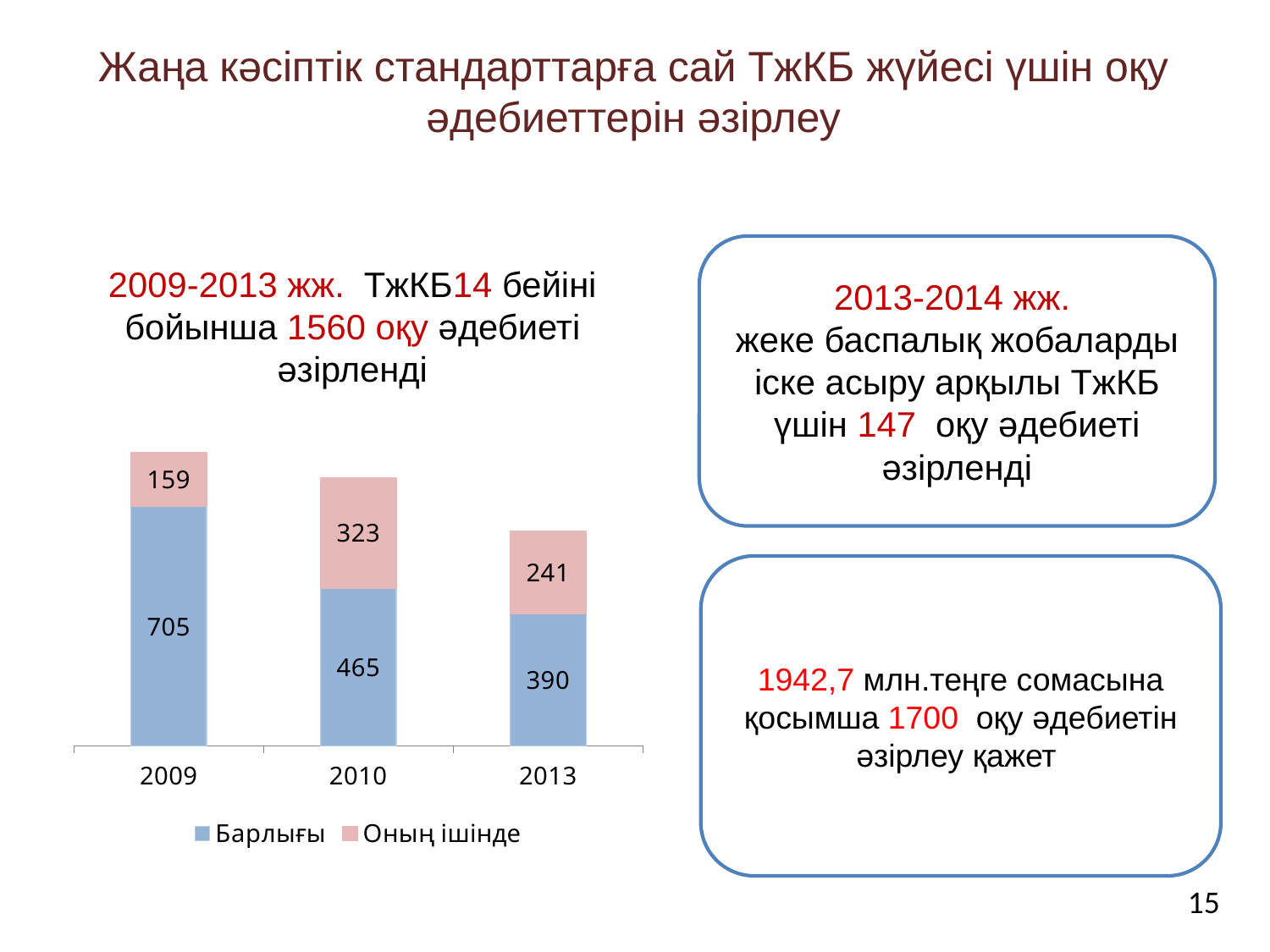
What kind of chart is shown on the slide? Stacked bar chart What is the difference between the Барлығы values for 2009 and 2013? 315 Which year has the highest value for the Барлығы series? 2009 What is the value of the Барлығы series for 2013? 390 What is the value of the Барлығы series for 2009? 705 What is the total of the stacked bar for 2010? 788 Which is larger: the Оның ішінде value for 2010 or for 2013? 2010 Which year has the lowest value for the Оның ішінде series? 2009 What is the value of the Оның ішінде series for 2013? 241 How many years are shown on the x axis of the chart? 3 What is the value of the Оның ішінде series for 2010? 323 How many series does the chart legend list? 2